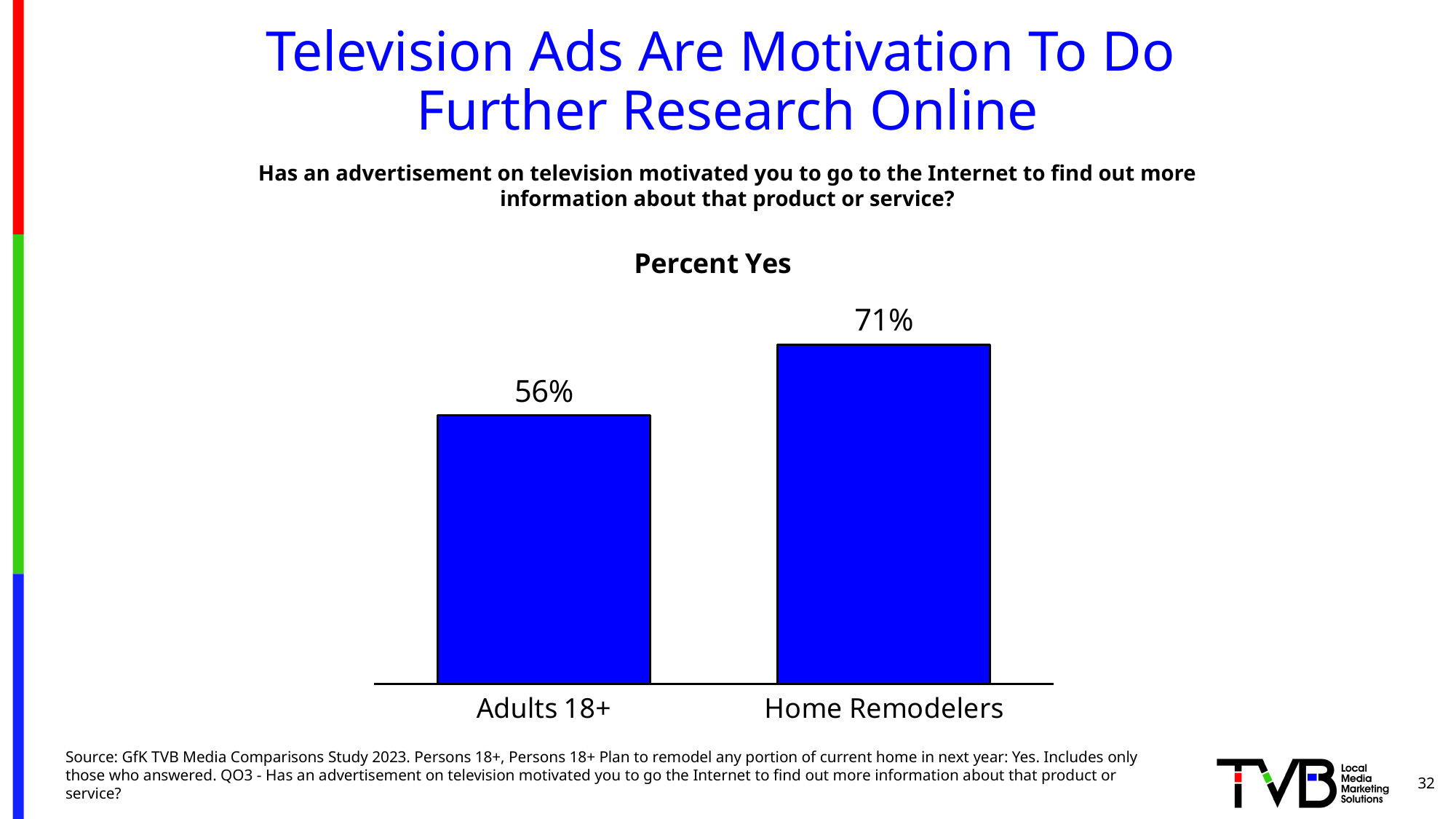
What is the Percent Yes value for Adults 18+? 56% What is the difference in Percent Yes between Home Remodelers and Adults 18+? 15% What is the Percent Yes value for Home Remodelers? 71% Do the values rise or fall from Adults 18+ to Home Remodelers? Rise Which category has the lowest Percent Yes value? Adults 18+ What kind of chart is shown on the slide? Bar chart Which category has the highest Percent Yes value? Home Remodelers How many categories are shown in the chart? 2 What is the title of the chart? Percent Yes What colour are the bars in the chart? Blue Which is larger, the Percent Yes for Adults 18+ or for Home Remodelers? Home Remodelers